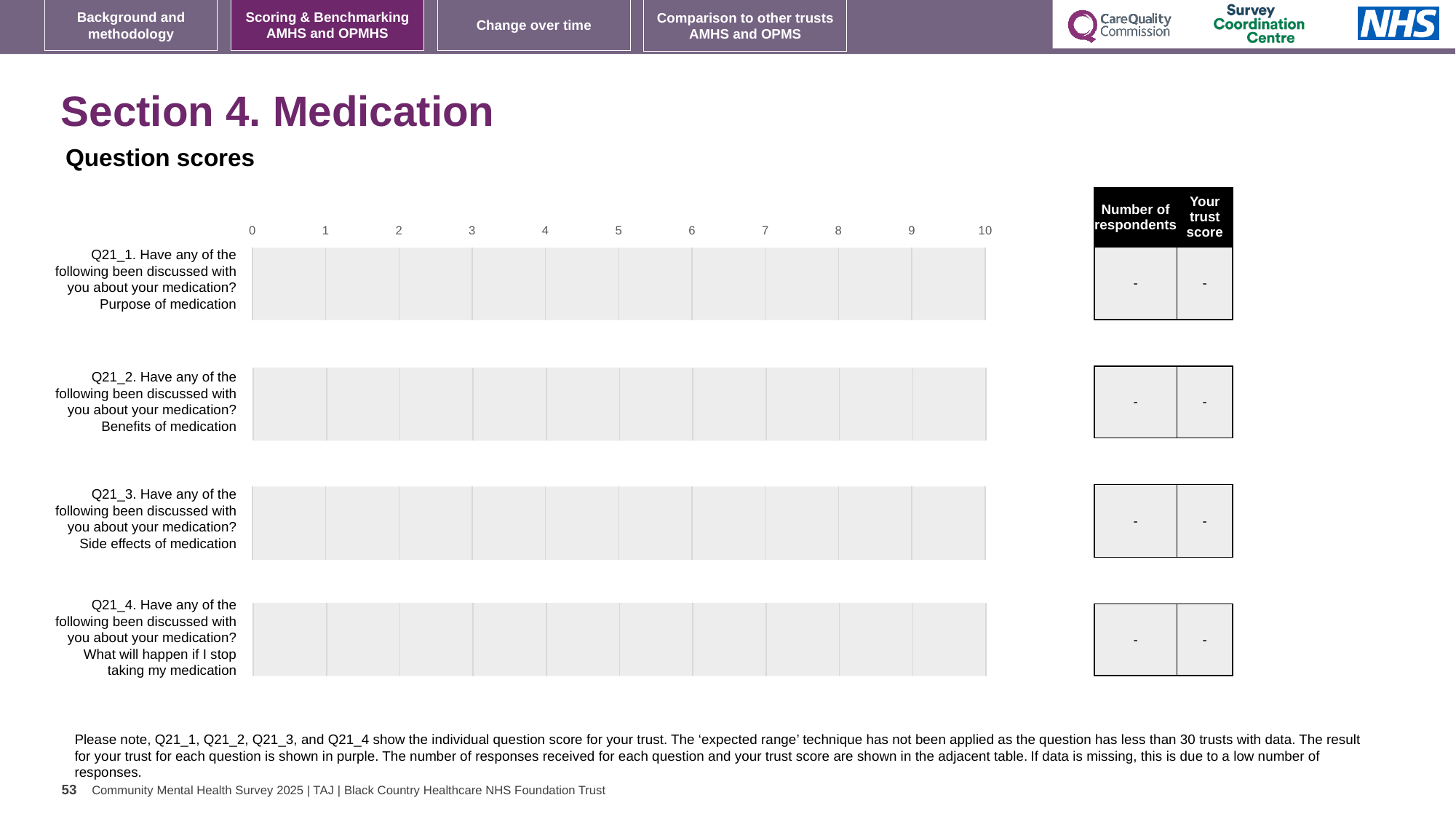
What is the 'Your trust score' value shown in the table for Q21_3 (Side effects of medication)? - What is the 'Number of respondents' value shown in the table for Q21_4 (What will happen if I stop taking my medication)? - What is the 'Number of respondents' value shown in the table for Q21_2 (Benefits of medication)? - What is the 'Your trust score' value shown in the table for Q21_1 (Purpose of medication)? - What kind of chart is used on this slide for the question scores? bar chart How many question rows (categories) are shown in the chart area on this slide? 4 What is the highest value shown on the chart's horizontal axis? 10 What is the lowest value shown on the chart's horizontal axis? 0